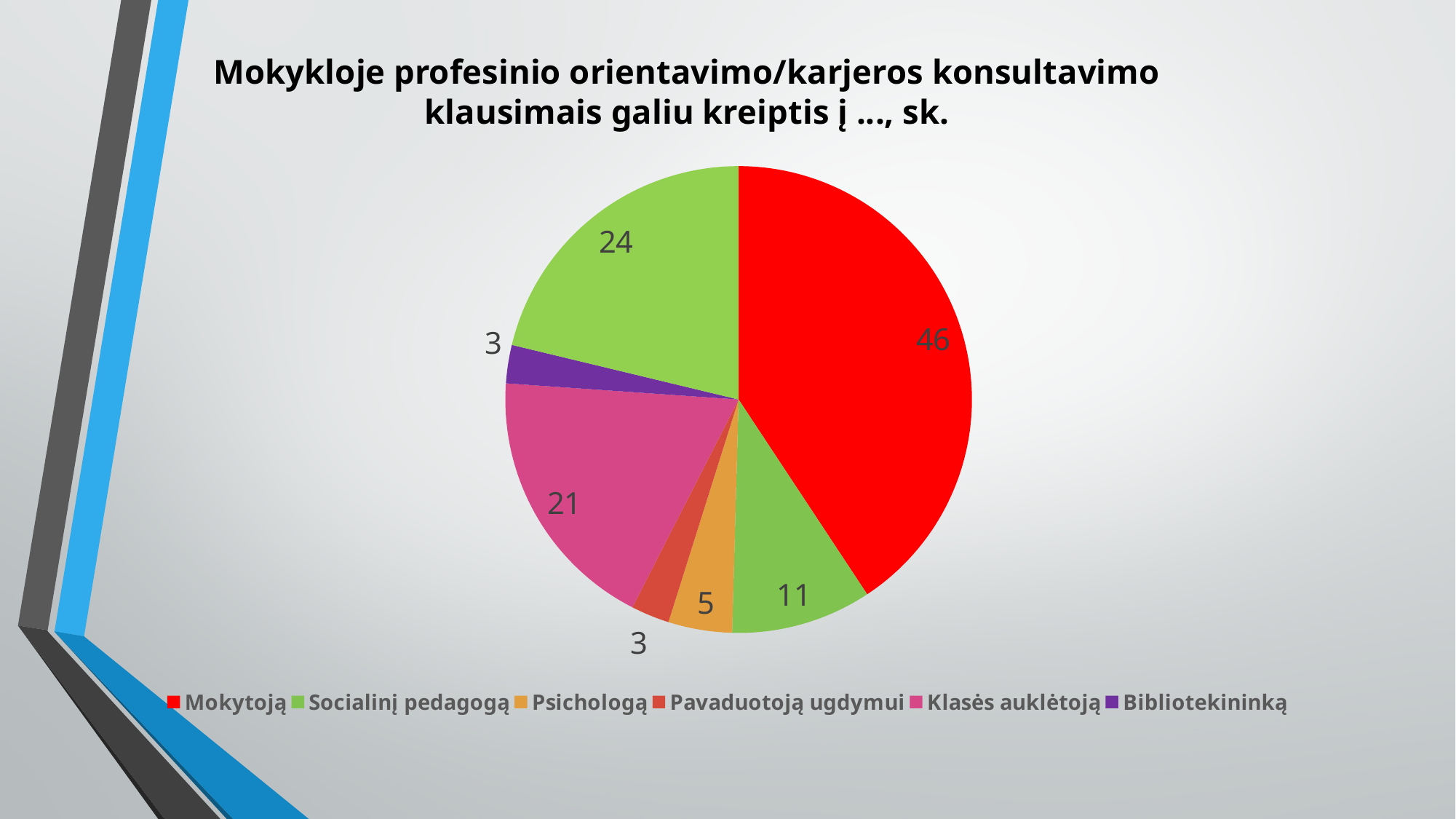
What is the value for Mokytoją? 46 What is the value for Pavaduotoją ugdymui? 3 What colour is the slice for Klasės auklėtoją? pink What type of chart is shown on the slide? pie chart How many entries does the legend list? 6 What is the value for Psichologą? 5 What is the value for Bibliotekininką? 3 Which is larger, the value for Psichologą or the value for Socialinį pedagogą? Socialinį pedagogą What is the value for Klasės auklėtoją? 21 Which category has the largest slice? Mokytoją What is the difference between the values for Mokytoją and Klasės auklėtoją? 25